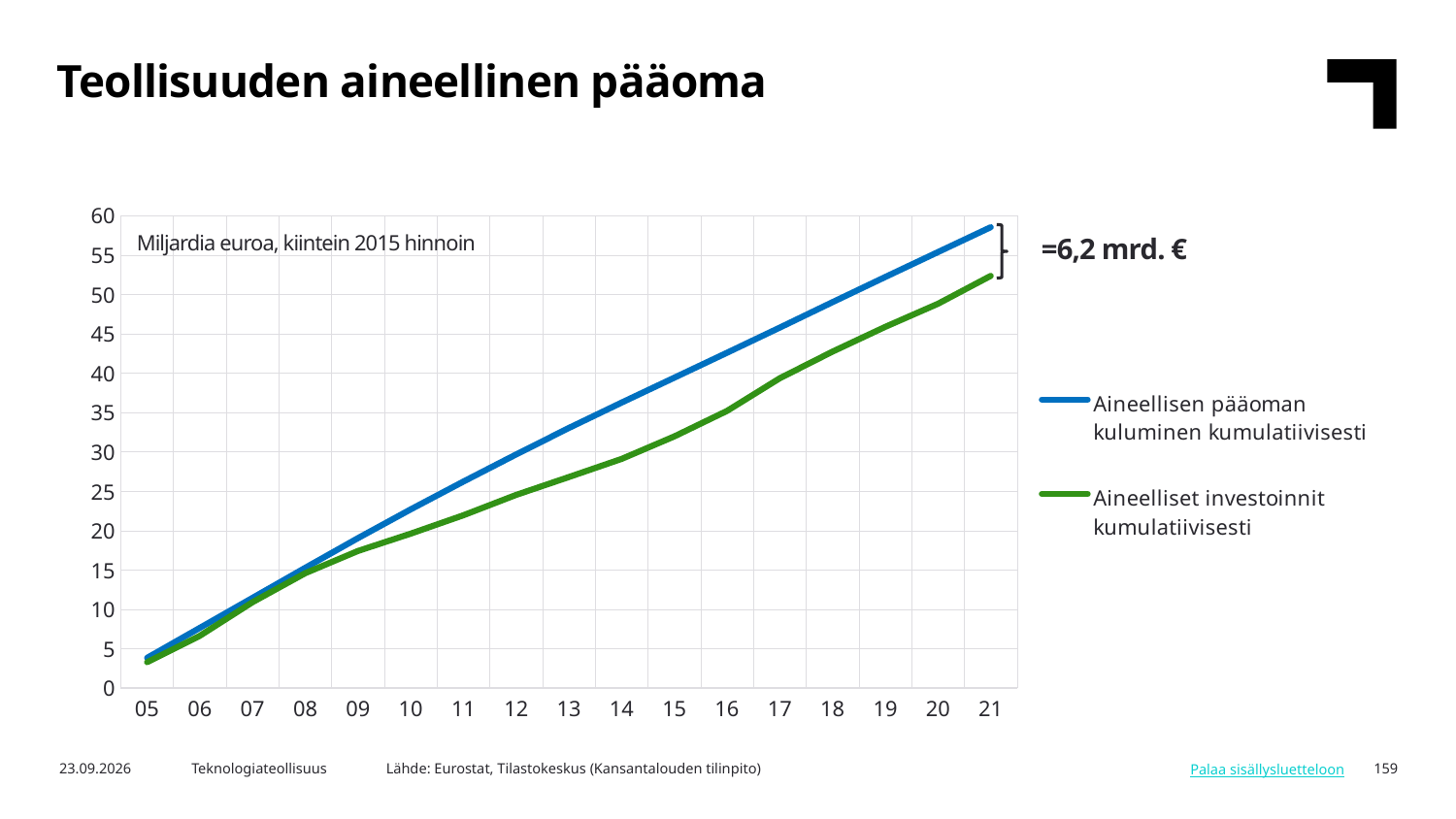
What is the difference between the two series in 2021, as annotated on the chart? 6,2 mrd. € Do the values of Aineelliset investoinnit kumulatiivisesti rise or fall from 05 to 21? rise What is the title of the slide? Teollisuuden aineellinen pääoma Is the value for Aineelliset investoinnit kumulatiivisesti in 2020 greater or less than 50? less How many series does the legend list? 2 In what unit are the values on the chart expressed, according to the note inside the chart? Miljardia euroa, kiintein 2015 hinnoin What kind of chart is shown on the slide? line chart Is the value for Aineelliset investoinnit kumulatiivisesti in 2011 greater or less than 25? less Which series is higher in 2021, Aineellisen pääoman kuluminen kumulatiivisesti or Aineelliset investoinnit kumulatiivisesti? Aineellisen pääoman kuluminen kumulatiivisesti How many years are shown on the x axis? 17 Is the value for Aineellisen pääoman kuluminen kumulatiivisesti in 2015 greater or less than 35? greater